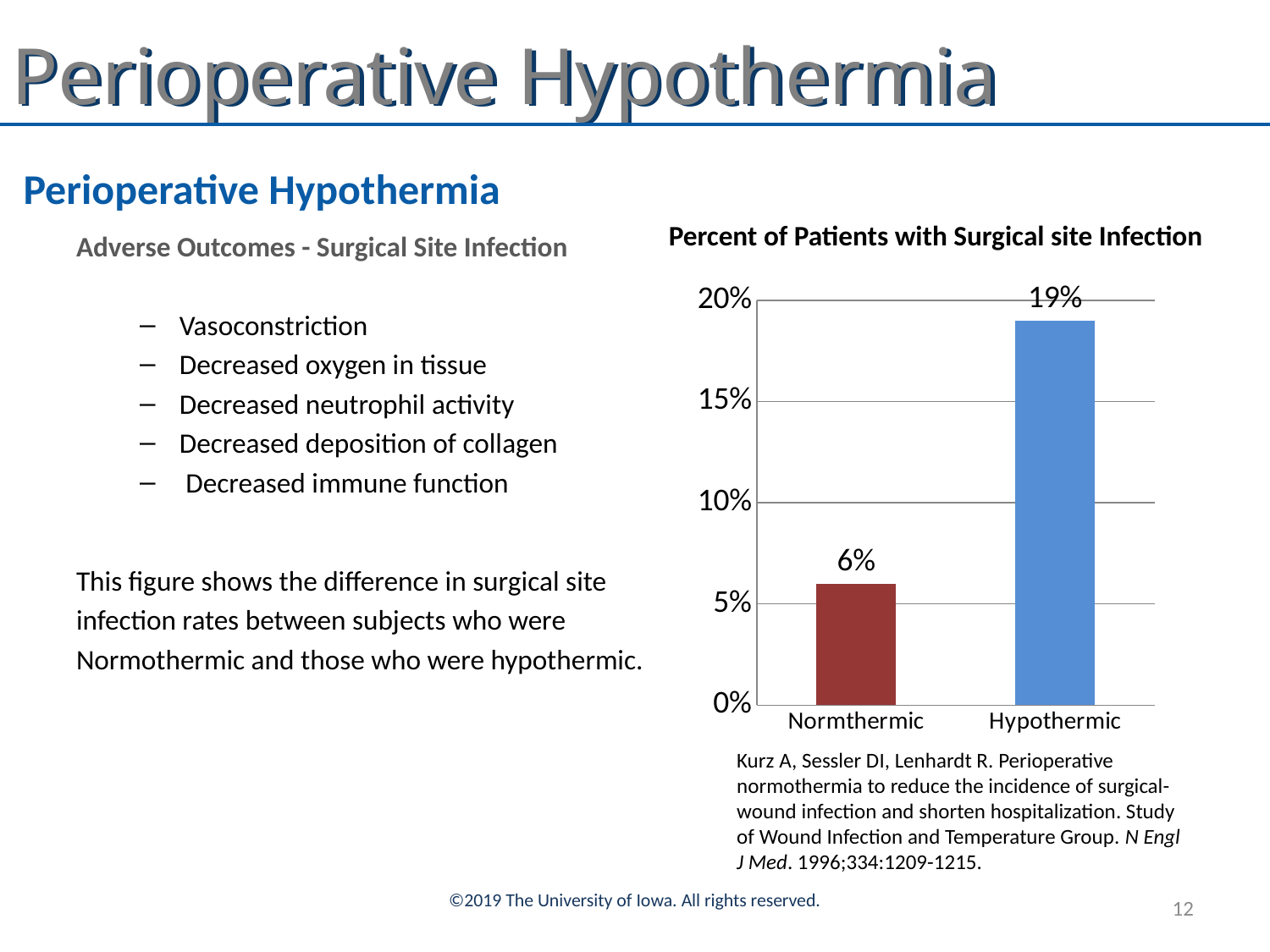
What is the percent of patients with surgical site infection for the Hypothermic group? 19% What is the highest value shown on the chart's y axis? 20% Which group has the higher percent of patients with surgical site infection? Hypothermic Is the value for Hypothermic greater or less than 15%? greater What is the percent of patients with surgical site infection for the Normthermic group? 6% Is the value for Normthermic greater or less than 10%? less What colour is the bar for the Hypothermic group? Blue What is the title of the chart? Percent of Patients with Surgical site Infection What kind of chart is shown on the slide? Bar chart What is the difference in surgical site infection percentage between the Hypothermic and Normthermic groups? 13% Which group has the lower percent of patients with surgical site infection? Normthermic How many categories are shown on the x axis of the chart? 2